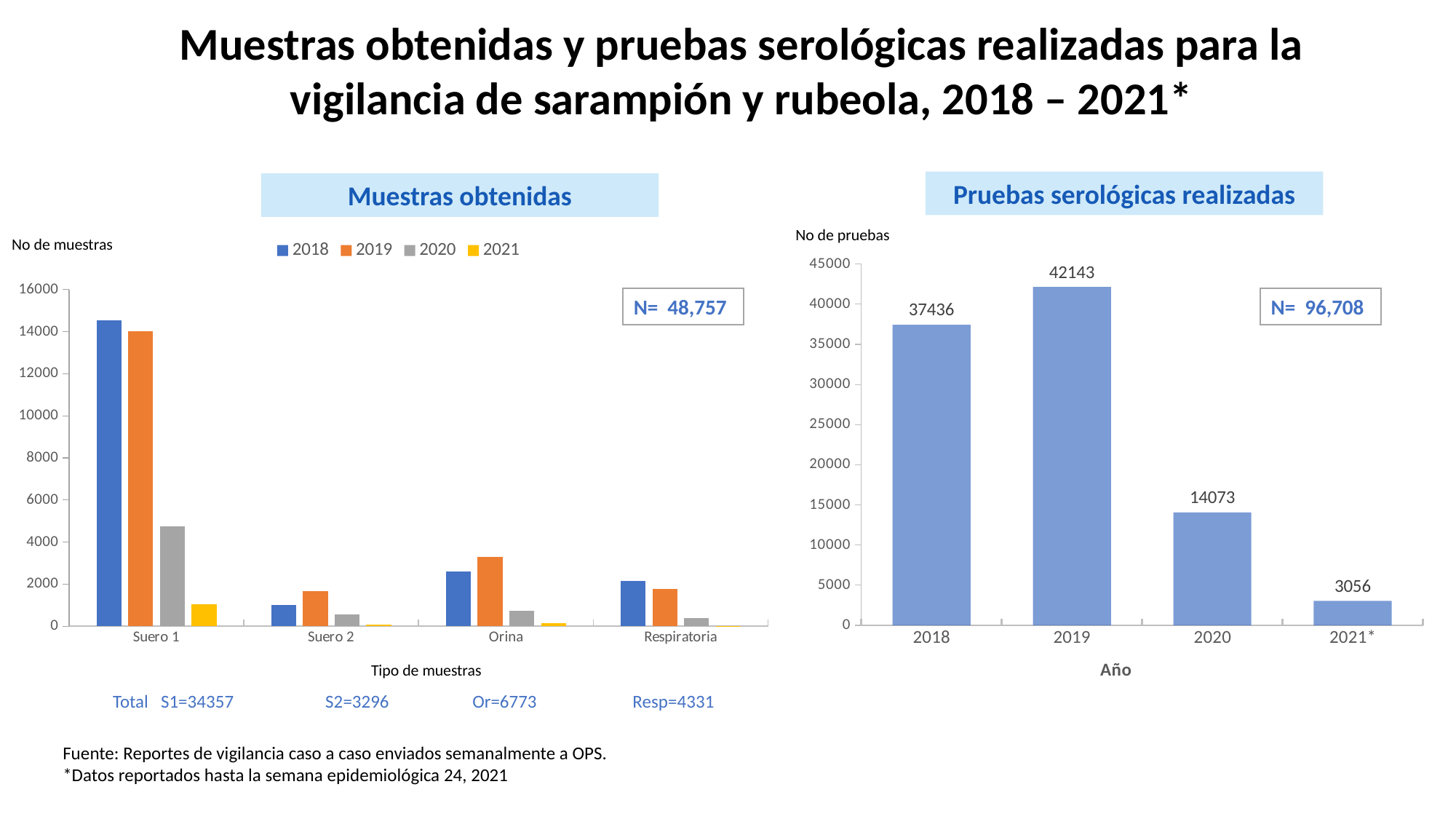
In the 'Muestras obtenidas' chart, is the 2020 value for Suero 1 greater or less than 6000? less In the 'Muestras obtenidas' chart, is the 2018 value for Suero 1 greater or less than 14000? greater What kind of chart is the 'Muestras obtenidas' chart? Bar chart In the 'Pruebas serológicas realizadas' chart, what is the difference between the values for 2020 and 2021*? 11017 In the 'Pruebas serológicas realizadas' chart, which year has the lowest value? 2021* In the 'Muestras obtenidas' chart, how many series does the legend list? 4 In the 'Pruebas serológicas realizadas' chart, which year has the highest value? 2019 In the 'Pruebas serológicas realizadas' chart, what is the difference between the values for 2019 and 2018? 4707 In the 'Muestras obtenidas' chart, which is larger for Orina: the 2018 value or the 2019 value? 2019 In the 'Pruebas serológicas realizadas' chart, what is the value for 2021*? 3056 In the 'Pruebas serológicas realizadas' chart, how many years are shown on the x axis? 4 In the 'Pruebas serológicas realizadas' chart, what is the value for 2019? 42143